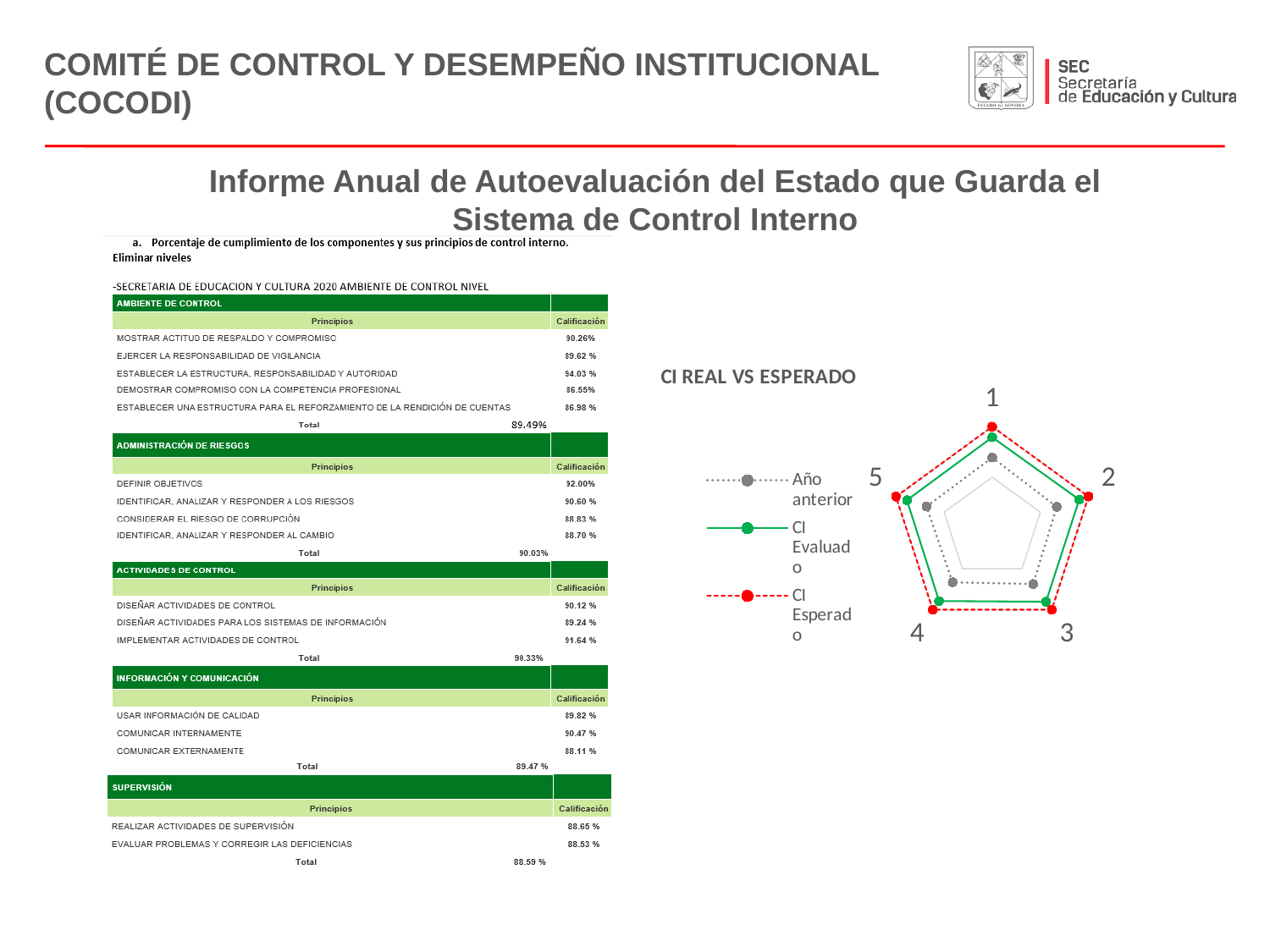
Which series forms the innermost polygon in the radar chart? Año anterior Which series forms the outermost polygon in the radar chart? CI Esperado Which series is drawn with a red dashed line in the chart? CI Esperado What kind of chart is shown on the slide? Radar chart At category 1, which series has the larger value: CI Esperado or CI Evaluado? CI Esperado At category 5, which series has the larger value: Año anterior or CI Esperado? CI Esperado At category 3, which series has the smaller value: Año anterior or CI Evaluado? Año anterior How many series does the legend of the chart list? 3 What is the title of the chart on the slide? CI REAL VS ESPERADO How many categories (axes) does the radar chart have? 5